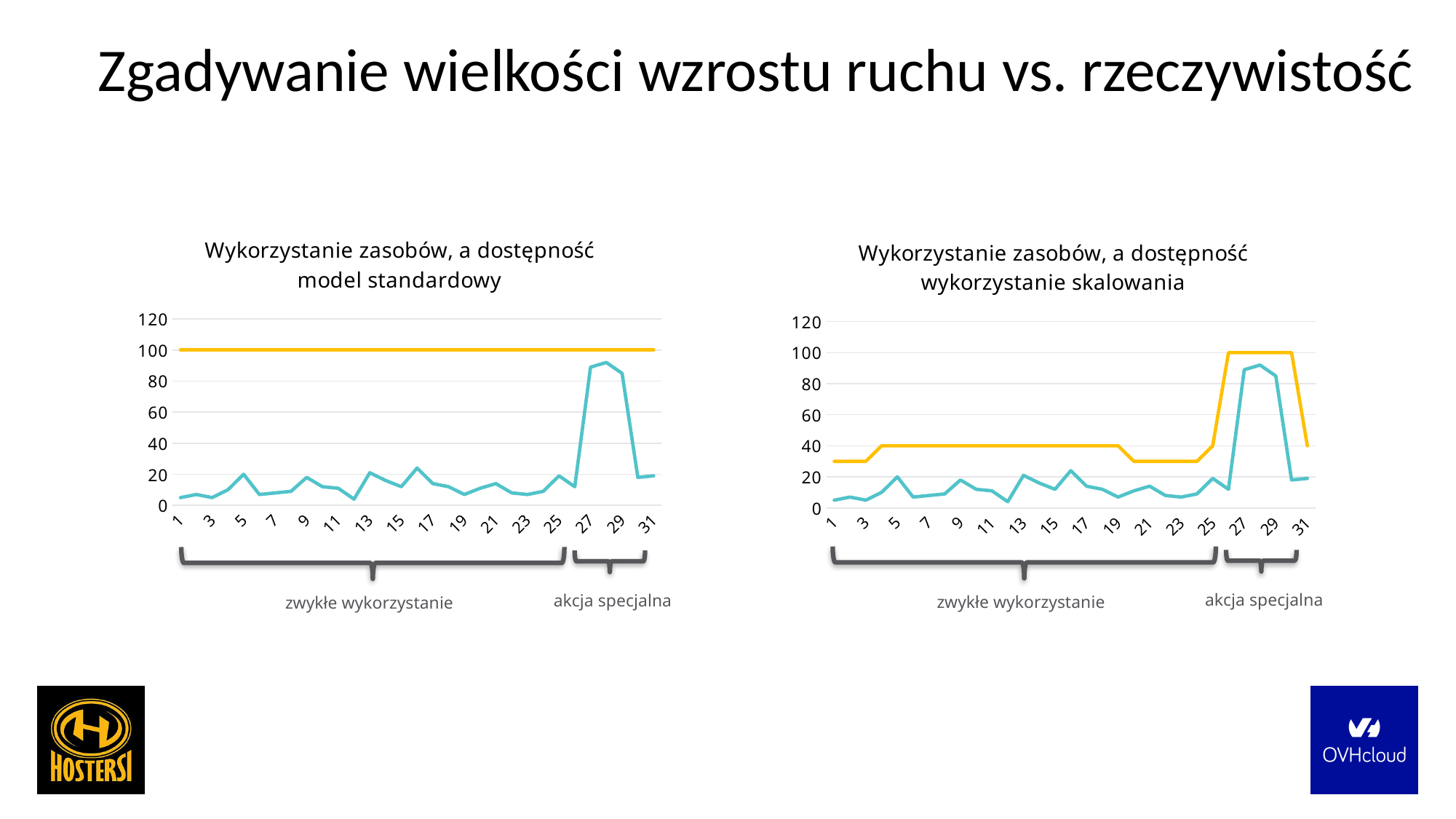
In the right chart (wykorzystanie skalowania), does the blue line rise or fall from day 29 to day 31? fall In the right chart (wykorzystanie skalowania), what value does the yellow line hold between days 5 and 19? 40 In the left chart (model standardowy), does the yellow line rise, fall, or stay flat across the x axis? stays flat In the left chart (model standardowy), what constant value does the yellow line hold across all days? 100 In the left chart (model standardowy), is the blue line's value at day 28 greater or less than 80? greater What kind of chart is the left chart, 'Wykorzystanie zasobów, a dostępność model standardowy'? line chart In the right chart (wykorzystanie skalowania), what value does the yellow line reach at day 27? 100 In the left chart (model standardowy), is the blue line's value at day 12 greater or less than 20? less In the right chart (wykorzystanie skalowania), is the blue line's value at day 27 greater or less than 60? greater In the left chart (model standardowy), is the blue line's value larger at day 1 or at day 28? day 28 In the left chart (model standardowy), which is larger at day 28: the yellow line or the blue line? the yellow line What is the title of the right chart? Wykorzystanie zasobów, a dostępność wykorzystanie skalowania